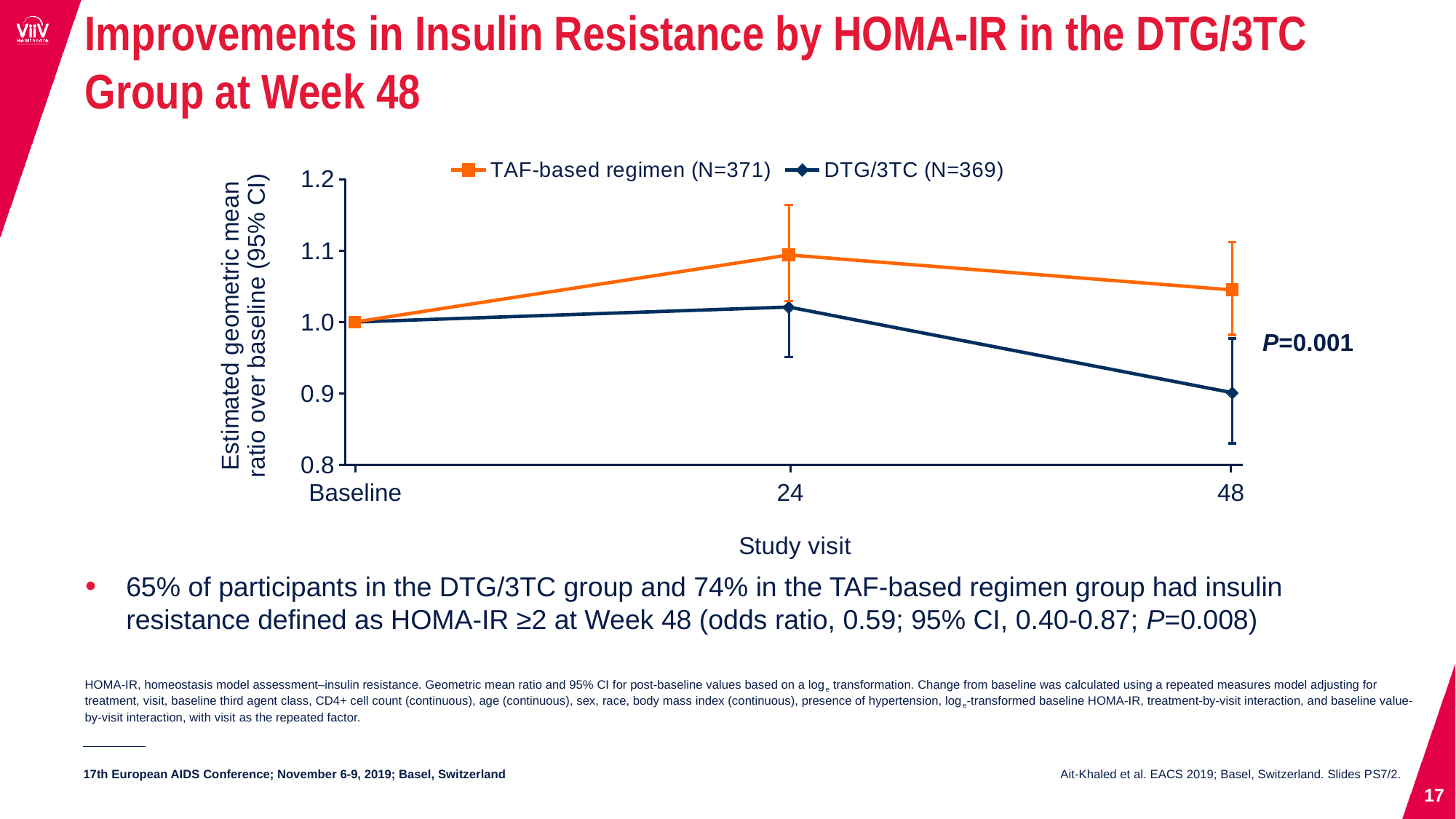
What is the estimated geometric mean ratio for both groups at Baseline? 1.0 At which study visit does the TAF-based regimen reach its highest value? 24 How many study visits are plotted along the x axis? 3 Is the value for the TAF-based regimen at week 48 greater or less than 1.0? greater Is the value for the TAF-based regimen at week 24 greater or less than 1.0? greater Does the DTG/3TC line rise or fall between week 24 and week 48? fall At week 48, which group has the higher estimated geometric mean ratio? TAF-based regimen Is the value for DTG/3TC at week 48 greater or less than 1.0? less What P value is printed next to the week 48 points? P=0.001 What kind of chart is shown on the slide? line chart What are the two series named in the legend? TAF-based regimen (N=371) and DTG/3TC (N=369) How many series does the legend list? 2